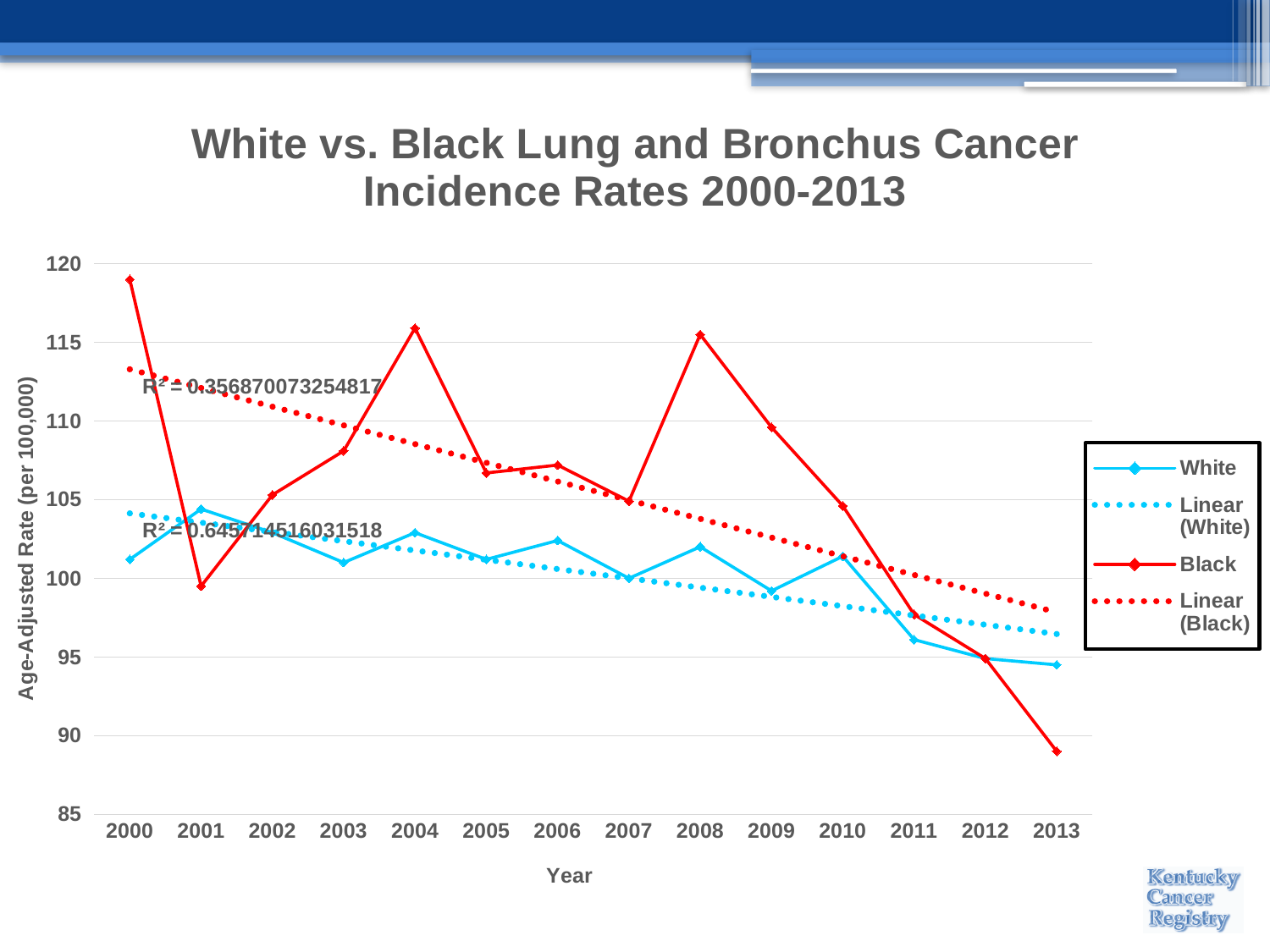
Is the Black incidence rate in 2008 greater or less than 110? greater Which series has the larger value in 2001, White or Black? White In which year is the White incidence rate lowest? 2013 In which year is the Black incidence rate lowest? 2013 How many years are plotted along the x axis? 14 How many series does the legend list? 4 Overall, does the Black incidence rate rise or fall from 2000 to 2013? Fall In which year is the Black incidence rate highest? 2000 Is the White incidence rate in 2011 greater or less than 100? less Which series has the larger value in 2013, White or Black? White What kind of chart is shown on the slide? Line chart Is the Black incidence rate in 2000 greater or less than 115? greater